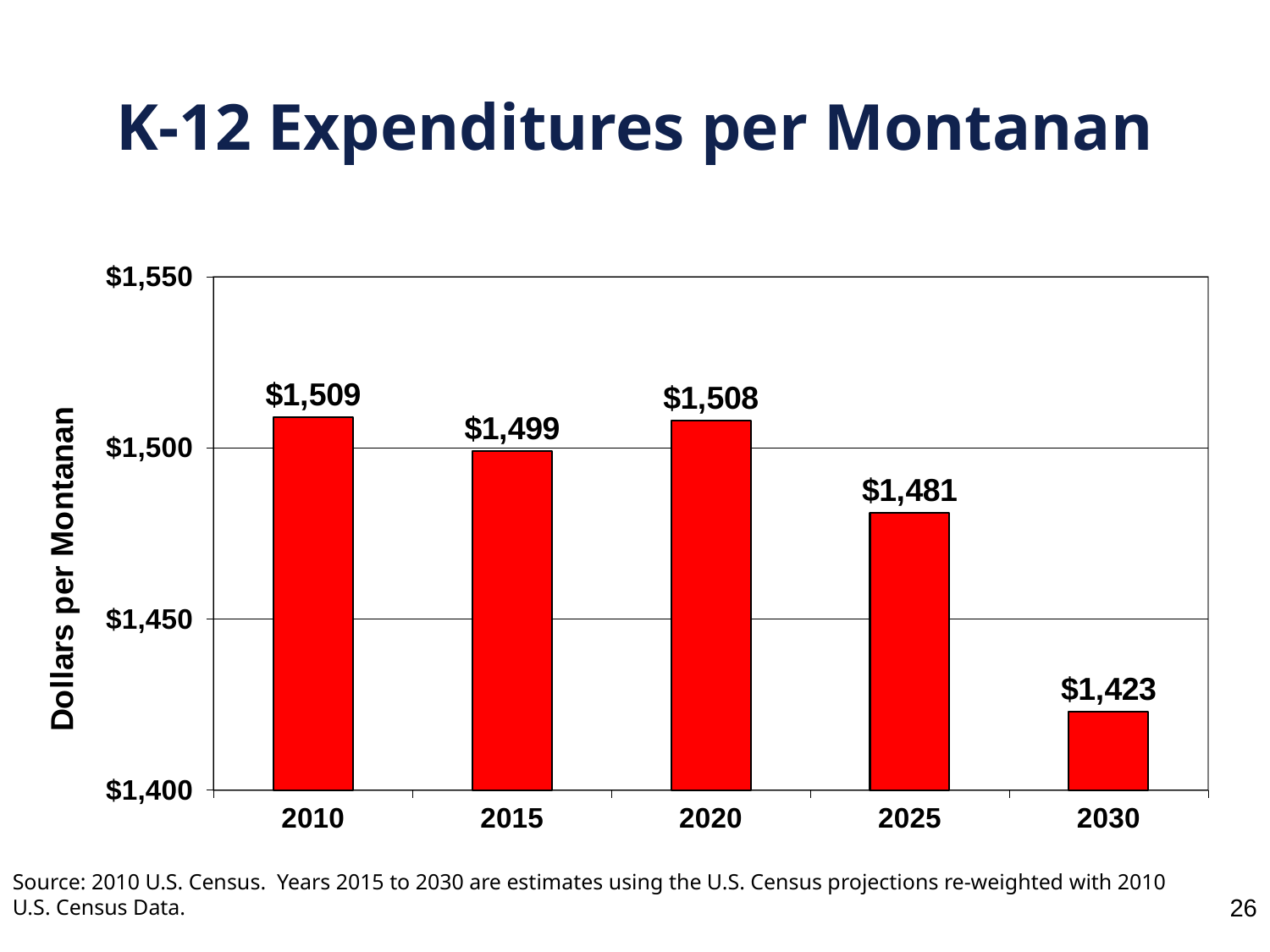
What is the difference between the 2020 and 2025 values? $27 What kind of chart is shown on the slide? bar chart Is the value for 2030 greater or less than $1,450? less Which is larger, the value for 2015 or the value for 2025? 2015 What is the label of the y axis? Dollars per Montanan What is the K-12 expenditure per Montanan in 2030? $1,423 What is the K-12 expenditure per Montanan in 2025? $1,481 Which year has the highest K-12 expenditure per Montanan? 2010 What is the difference between the 2010 and 2030 values? $86 What is the K-12 expenditure per Montanan in 2010? $1,509 Which year has the lowest K-12 expenditure per Montanan? 2030 How many years are shown on the x axis? 5